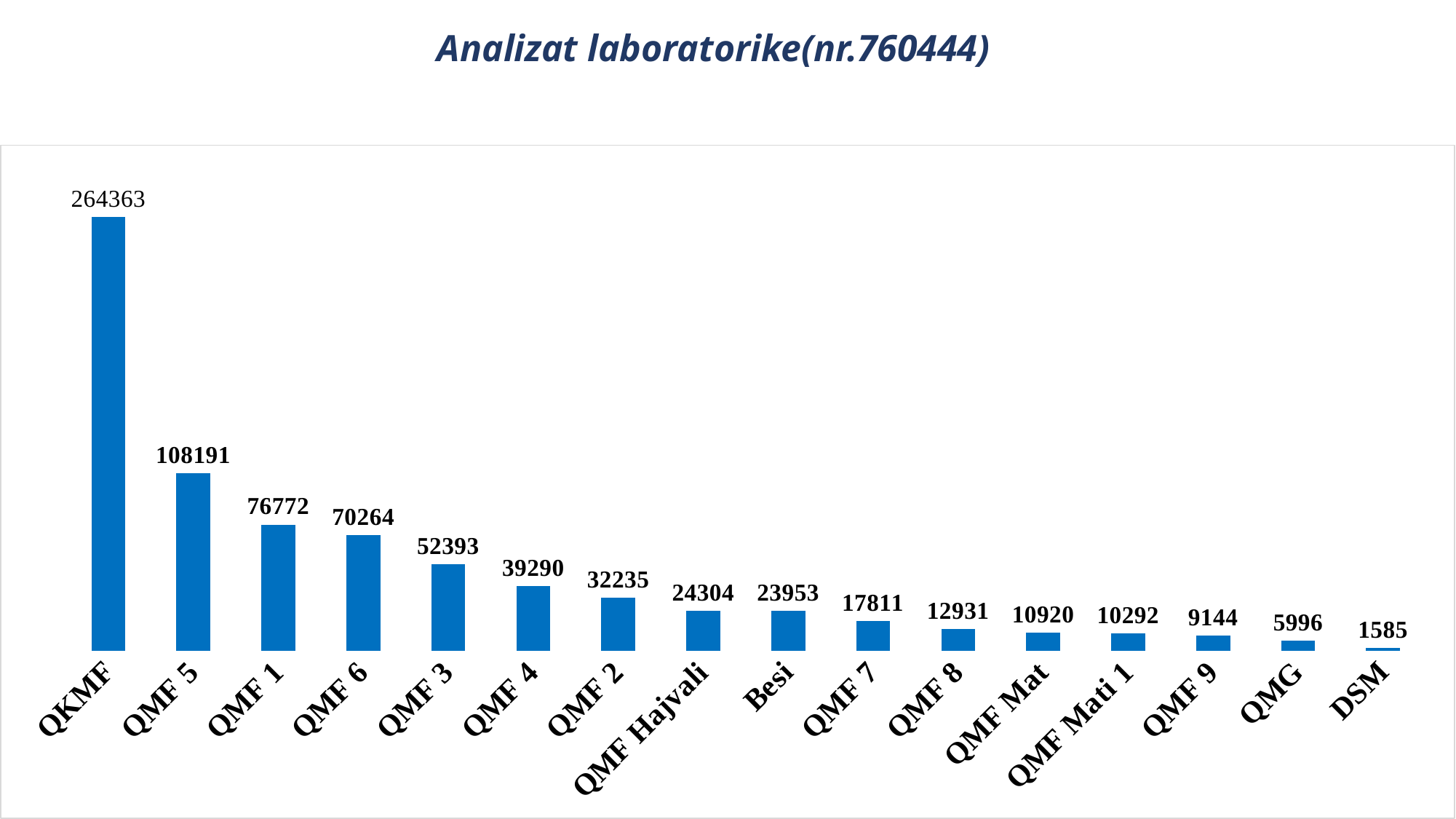
What is the value for QMF Mati 1? 10292 What is the value for QMF Hajvali? 24304 What is the title of the chart? Analizat laboratorike(nr.760444) How many categories are shown on the chart? 16 Which is larger, the value for QMF 9 or the value for QMG? QMF 9 What kind of chart is shown on the slide? Bar chart Which is larger, the value for QMF 3 or the value for QMF 4? QMF 3 What is the difference between the values for QKMF and QMF 5? 156172 Which category has the lowest value? DSM What is the difference between the values for QMF 1 and QMF 6? 6508 Which category has the highest value? QKMF What is the value for QKMF? 264363